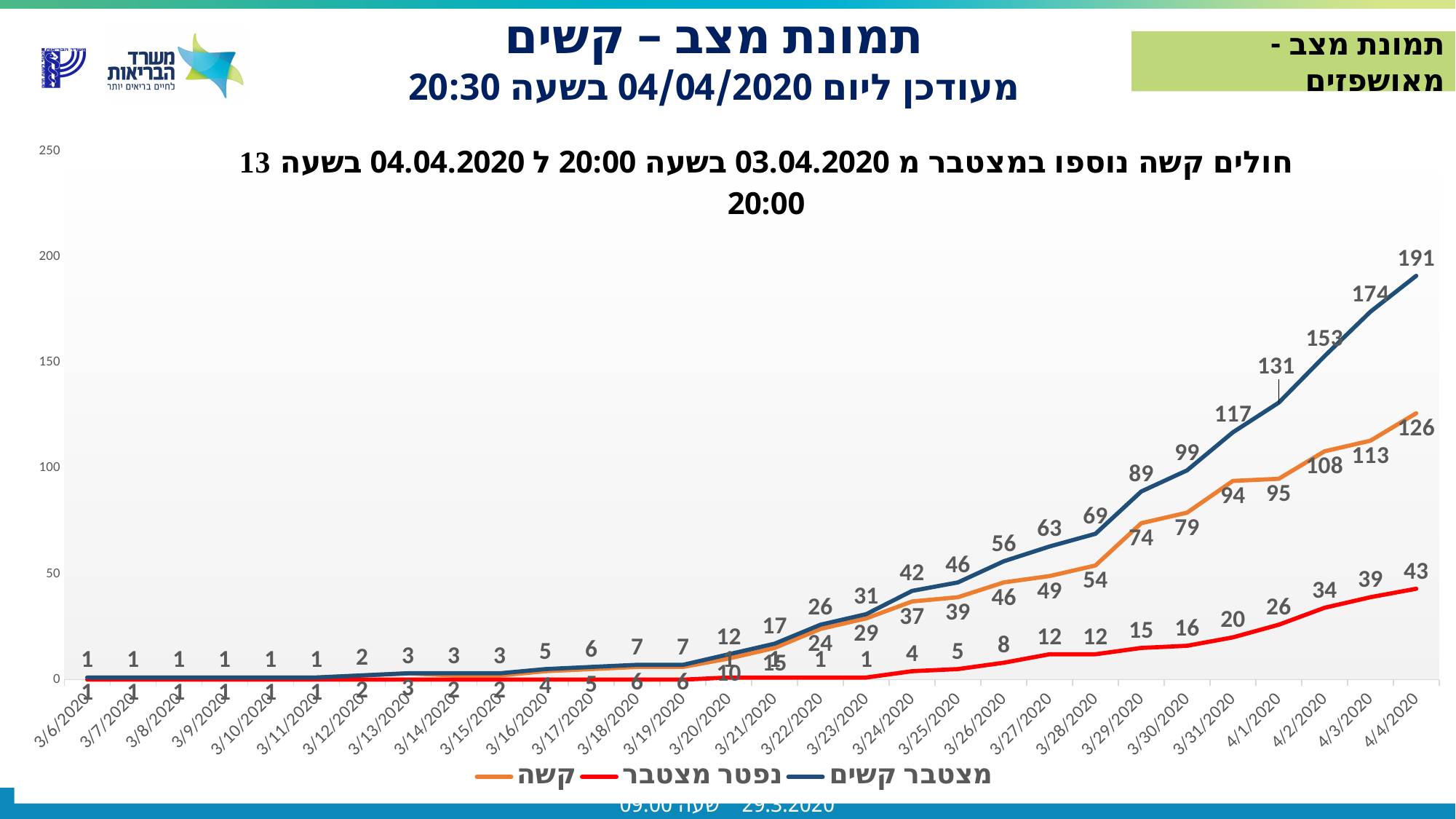
Which series has the lowest value on 4/4/2020? נפטר מצטבר What is the difference between the מצטבר קשים values on 4/4/2020 and 4/3/2020? 17 What is the value of the קשה series on 4/4/2020? 126 What is the value of the מצטבר קשים series on 3/31/2020? 117 What is the value of the נפטר מצטבר series on 4/4/2020? 43 What kind of chart is shown on the slide? line chart What is the value of the מצטבר קשים series on 4/4/2020? 191 Does the מצטבר קשים series rise or fall from 3/6/2020 to 4/4/2020? rise Which series has the highest value on 4/4/2020? מצטבר קשים Is the value of the קשה series on 4/2/2020 larger or smaller than the value of the נפטר מצטבר series on the same date? larger How many series does the legend list? 3 How many dates are shown on the x axis? 30